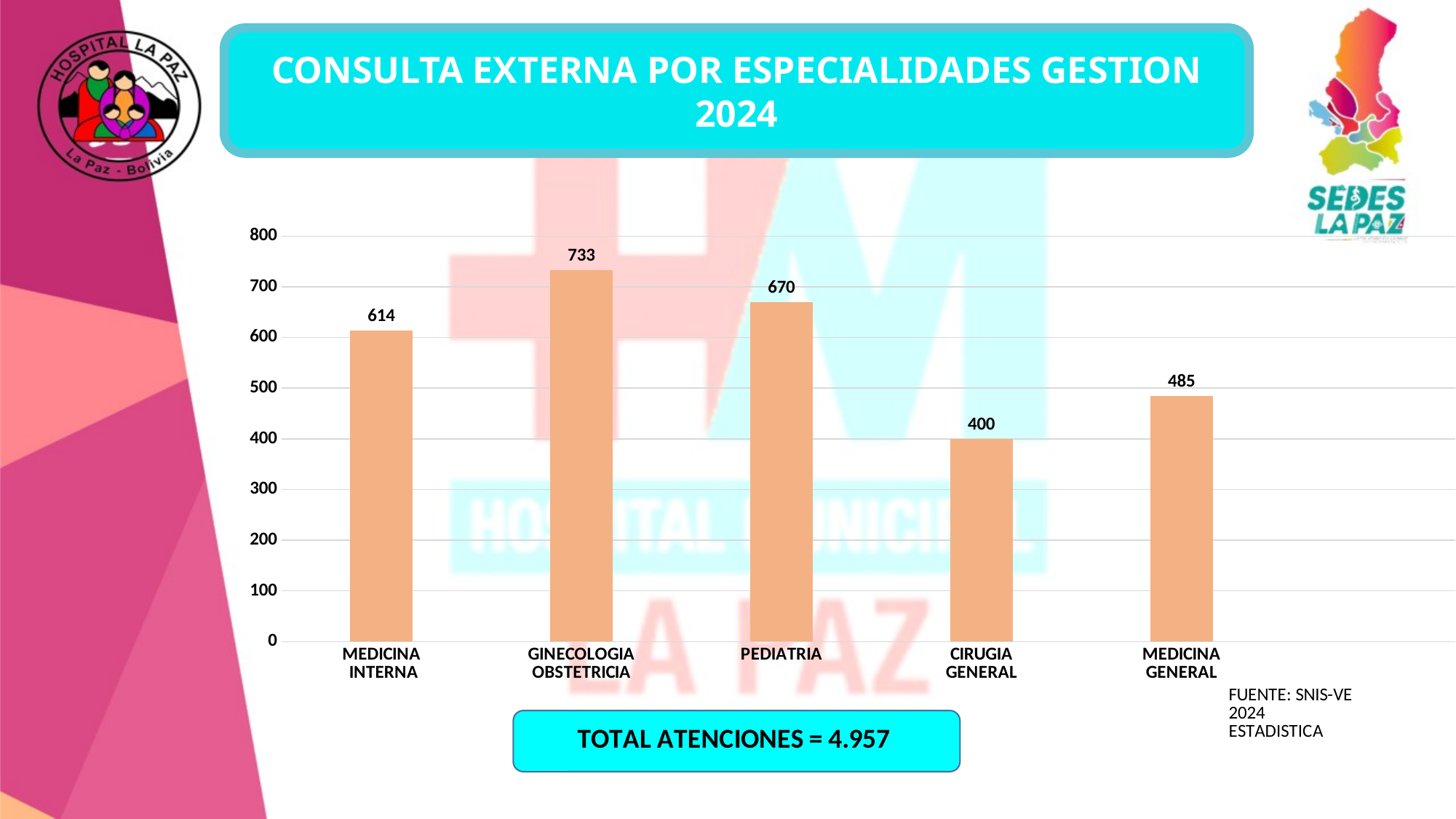
What is the value for GINECOLOGIA OBSTETRICIA? 733 Which specialty has the highest value? GINECOLOGIA OBSTETRICIA What is the value for CIRUGIA GENERAL? 400 Which specialty has the lowest value? CIRUGIA GENERAL What is the value for MEDICINA INTERNA? 614 How many specialties are shown in the chart? 5 What kind of chart is shown on the slide? Bar chart What is the title of the chart on the slide? CONSULTA EXTERNA POR ESPECIALIDADES GESTION 2024 What is the difference between the values for GINECOLOGIA OBSTETRICIA and PEDIATRIA? 63 What is the value for PEDIATRIA? 670 Which is larger, the value for MEDICINA INTERNA or the value for MEDICINA GENERAL? MEDICINA INTERNA What is the value for MEDICINA GENERAL? 485